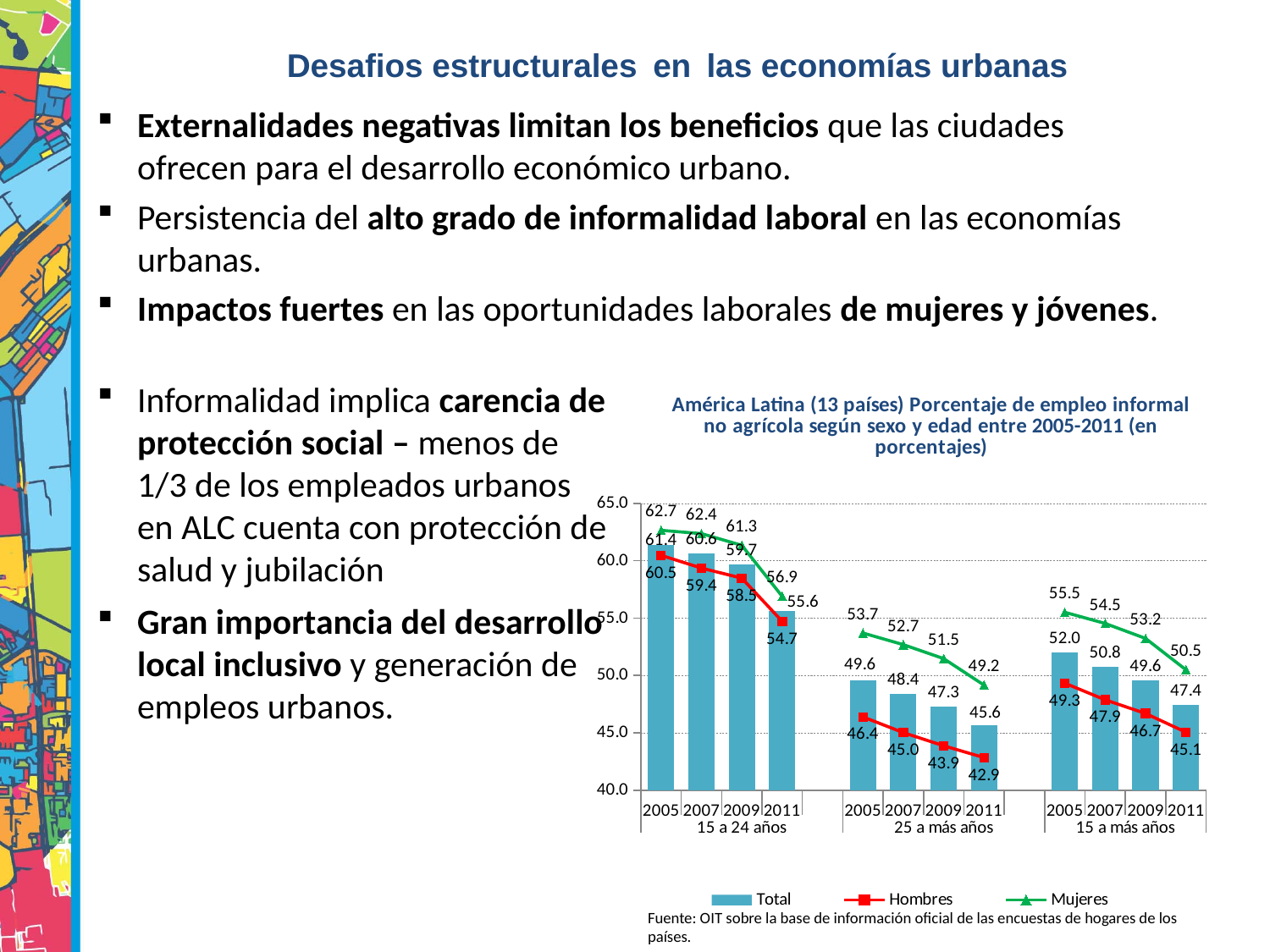
Do the Total values rise or fall from 2005 to 2011 in the 15 a más años group? fall Which year has the highest Total value in the 15 a 24 años group? 2005 What is the Total value for 2011 in the 25 a más años group? 45.6 Which year has the lowest Hombres value in the 25 a más años group? 2011 How many age groups are shown on the x axis? 3 Which series is plotted as bars in the chart? Total What is the Total value for 2005 in the 15 a más años group? 52.0 How many series does the chart legend list? 3 Which is larger in 2007 for the 15 a 24 años group: the Hombres value or the Mujeres value? Mujeres What is the Hombres value for 2009 in the 15 a más años group? 46.7 What is the difference between the Mujeres and Hombres values for 2011 in the 25 a más años group? 6.3 What is the Mujeres value for 2005 in the 15 a 24 años group? 62.7